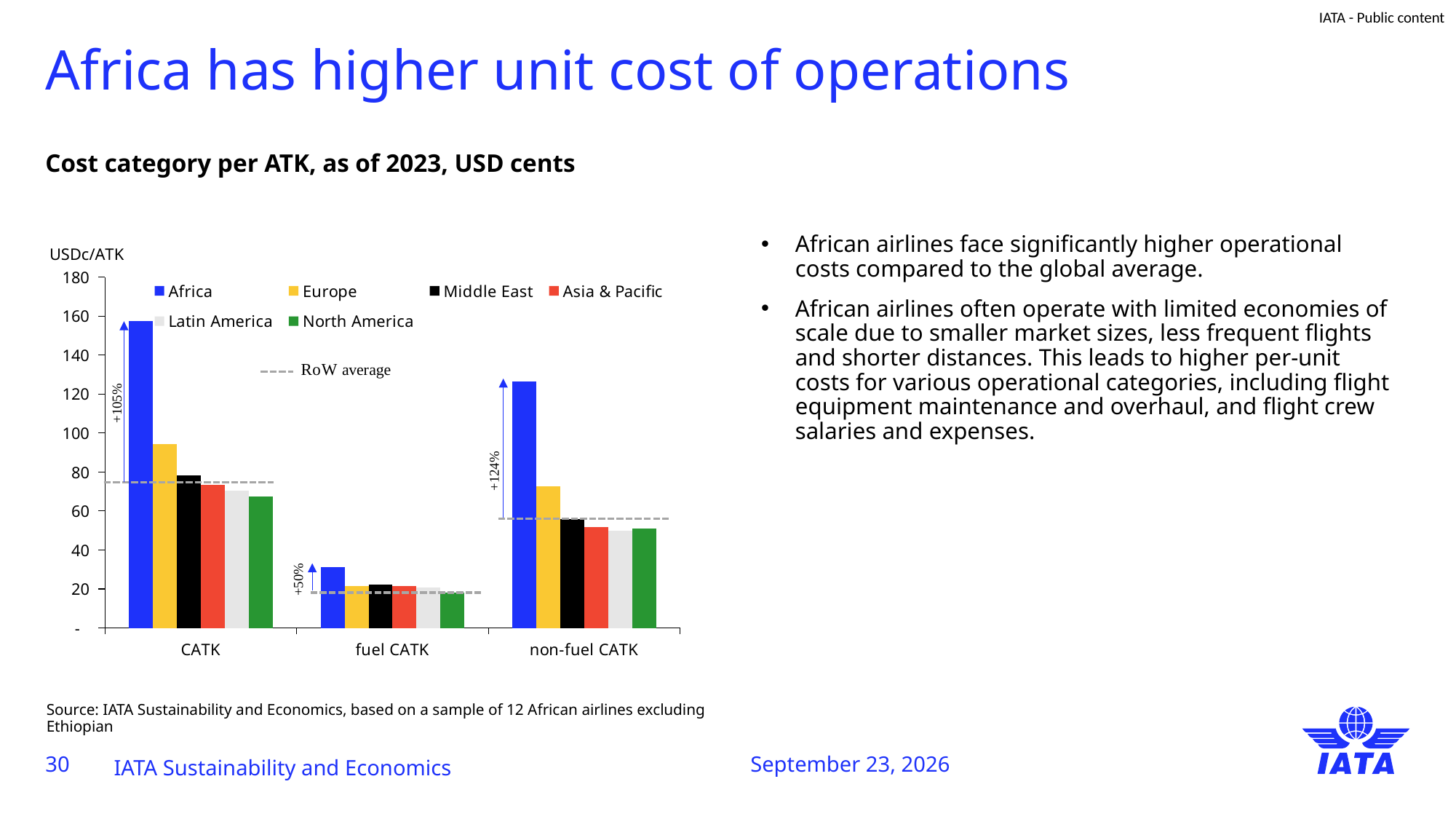
How many cost categories are shown on the x axis of the chart? 3 What kind of chart is shown on the slide? bar chart Is the value for Africa in non-fuel CATK greater or less than 120? greater Which region has the lowest value for fuel CATK? North America How many regions does the chart's legend list? 6 Which region has the highest value for CATK? Africa Is the value for Africa in CATK greater or less than 140? greater What does the dashed grey line in the chart represent? RoW average Is the value for Europe in CATK greater or less than 80? greater Which is larger for CATK, Europe or Middle East? Europe What percentage annotation is shown above the Africa bar for non-fuel CATK? +124%